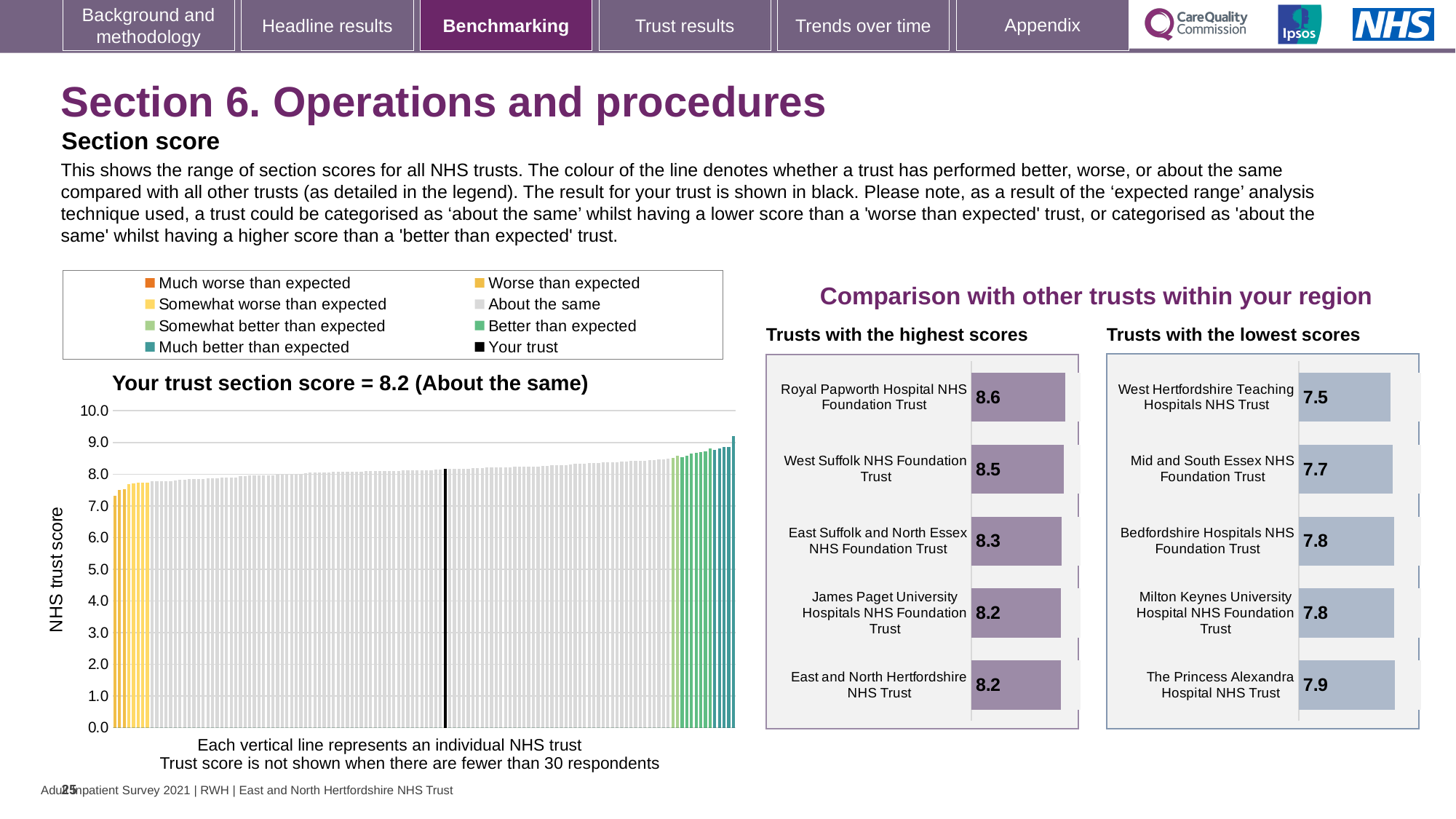
What kind of chart is the 'Your trust section score' chart? Bar chart How many entries does the legend above the 'Your trust section score' chart list? 8 In the 'Trusts with the highest scores' chart, which trust has the highest score? Royal Papworth Hospital NHS Foundation Trust What is the y-axis label of the 'Your trust section score' chart? NHS trust score In the 'Trusts with the highest scores' chart, what is the score for Royal Papworth Hospital NHS Foundation Trust? 8.6 In the 'Your trust section score' chart, what category is your trust's score placed in? About the same In the 'Trusts with the lowest scores' chart, which has the higher score: Mid and South Essex NHS Foundation Trust or Bedfordshire Hospitals NHS Foundation Trust? Bedfordshire Hospitals NHS Foundation Trust In the 'Trusts with the lowest scores' chart, what is the difference between the scores of The Princess Alexandra Hospital NHS Trust and West Hertfordshire Teaching Hospitals NHS Trust? 0.4 In the 'Your trust section score' chart, do the trust scores rise or fall from left to right? Rise In the 'Trusts with the lowest scores' chart, what is the score for West Hertfordshire Teaching Hospitals NHS Trust? 7.5 In the 'Trusts with the highest scores' chart, how many trusts are shown? 5 In the 'Your trust section score' chart, what is the section score for your trust? 8.2